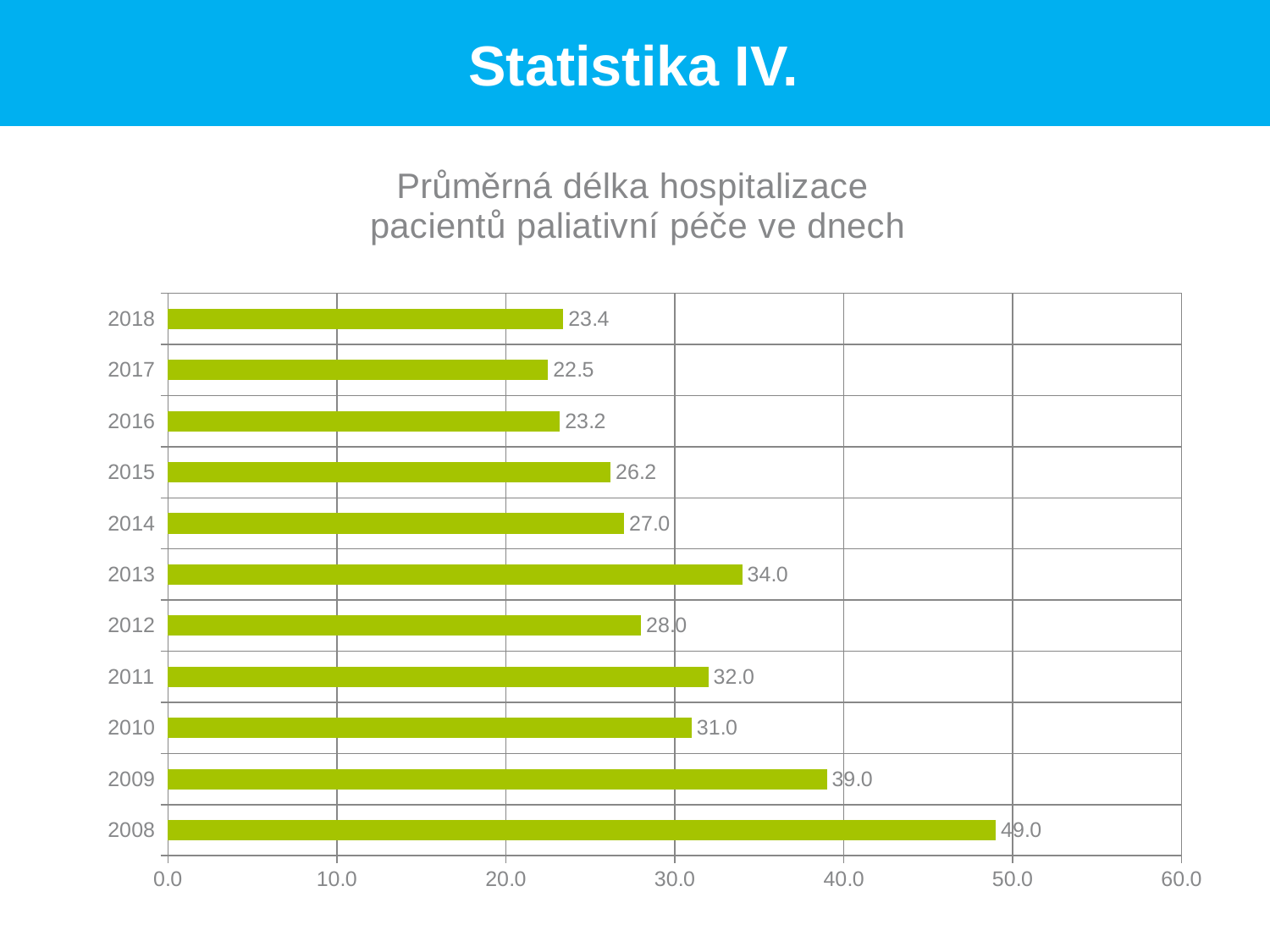
What value is shown for 2009? 39.0 What is the difference between the values for 2008 and 2018? 25.6 Is the value for 2009 greater or less than 40.0? less What is the average length of hospitalization for 2018? 23.4 How many years are shown in the chart? 11 What is the title of the chart? Průměrná délka hospitalizace pacientů paliativní péče ve dnech Which year has the lowest value? 2017 What is the difference between the values for 2011 and 2010? 1.0 Which year has the highest value? 2008 Which is larger, the value for 2013 or the value for 2012? 2013 What value is shown for 2013? 34.0 What kind of chart is shown on the slide? bar chart